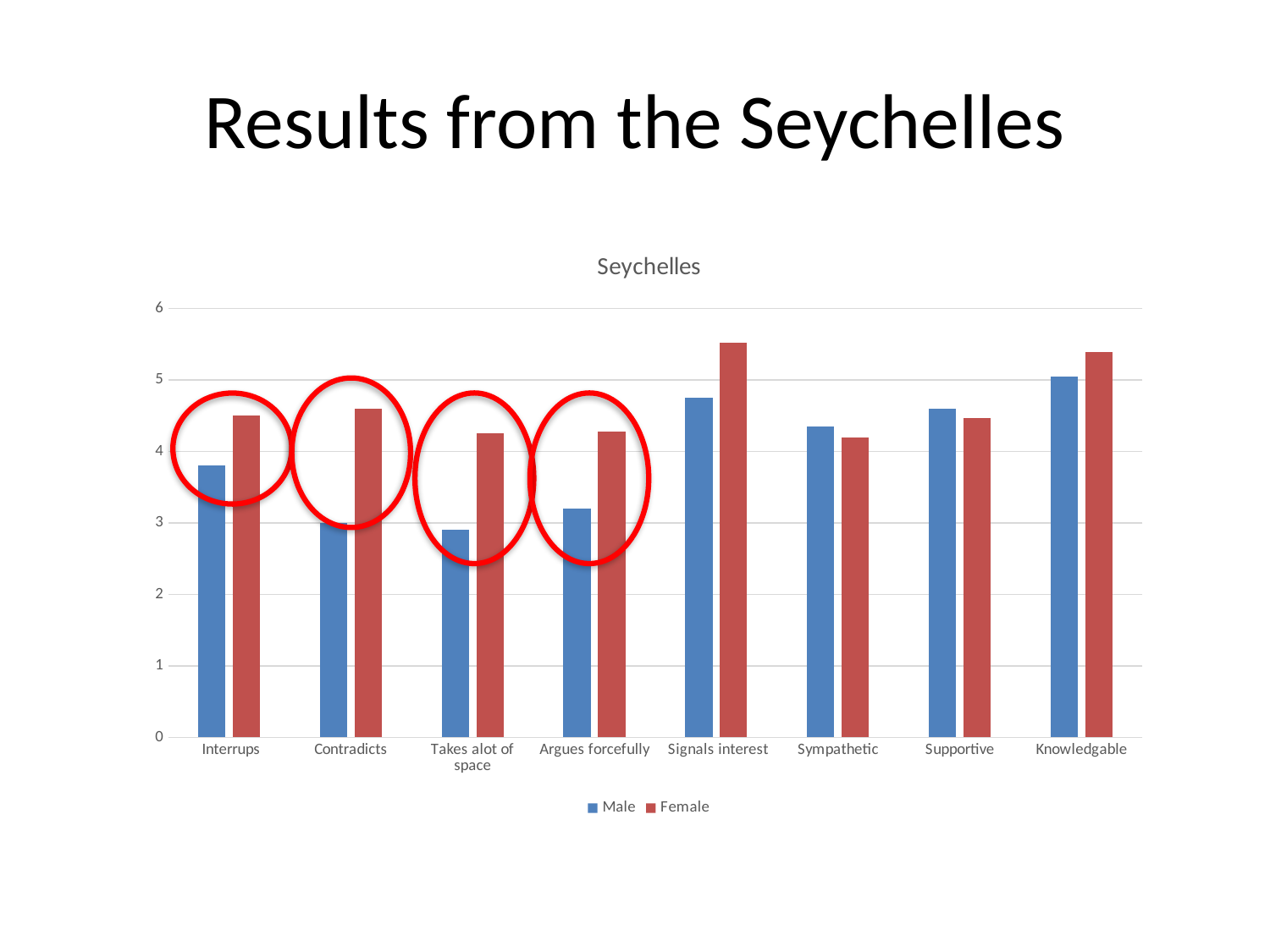
Is the Male value for Interrups greater or less than 4? less For Knowledgable, which is larger, the Male value or the Female value? Female Is the Female value for Signals interest greater or less than 5? greater For Contradicts, which is larger, the Male value or the Female value? Female What kind of chart is shown on the slide? bar chart How many series does the chart's legend list? 2 Which series are listed in the chart's legend? Male and Female Which category has the highest Male value? Knowledgable How many categories are shown on the x axis of the chart? 8 Is the Female value for Contradicts greater or less than 4? greater What is the title of the chart? Seychelles